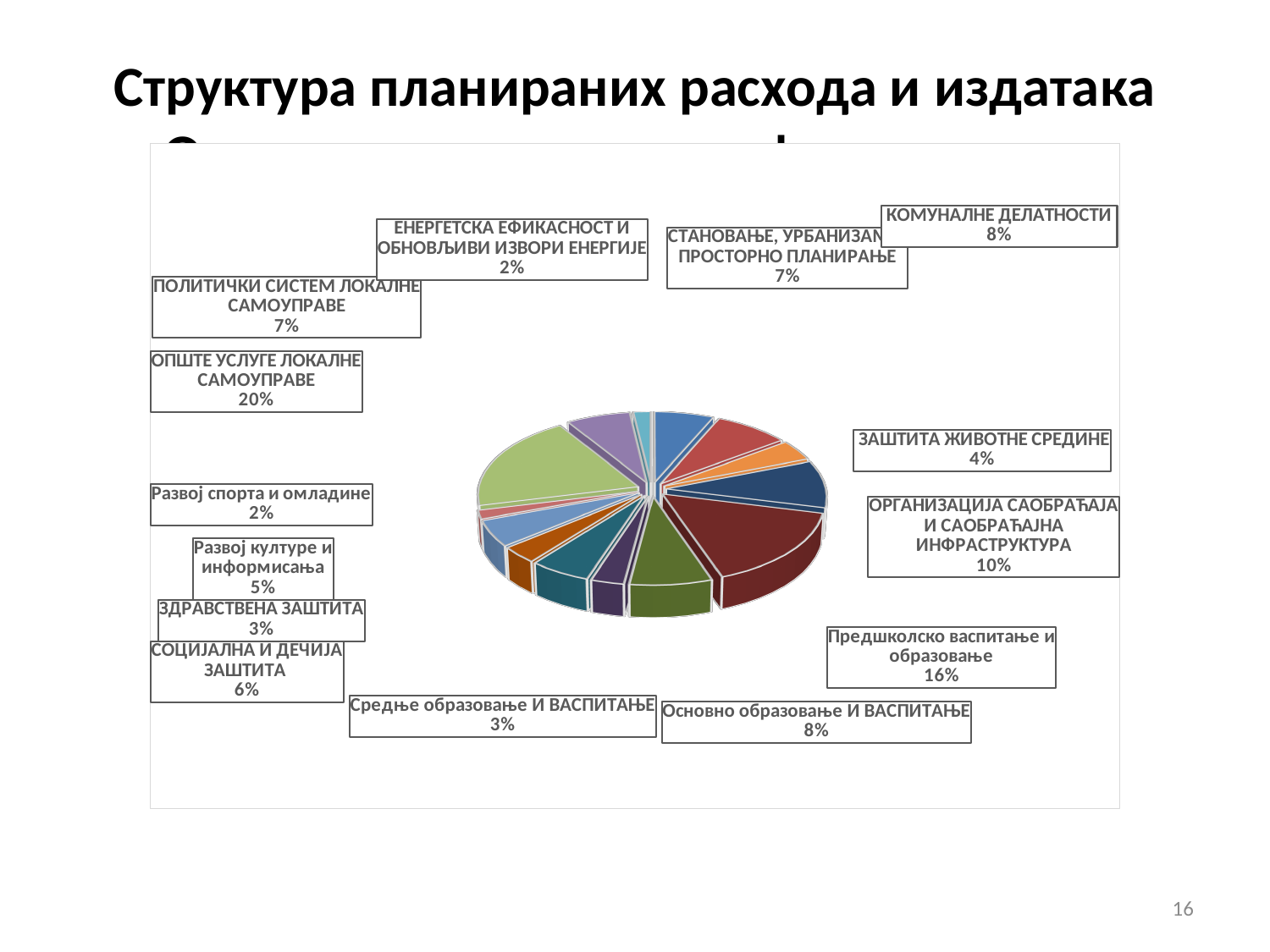
Which category has the largest share of the pie? ОПШТЕ УСЛУГЕ ЛОКАЛНЕ САМОУПРАВЕ What percentage is shown for СОЦИЈАЛНА И ДЕЧИЈА ЗАШТИТА? 6% Which has a larger share: Основно образовање И ВАСПИТАЊЕ or Средње образовање И ВАСПИТАЊЕ? Основно образовање И ВАСПИТАЊЕ What percentage is shown for КОМУНАЛНЕ ДЕЛАТНОСТИ? 8% What share of the pie does ОПШТЕ УСЛУГЕ ЛОКАЛНЕ САМОУПРАВЕ have? 20% What is the first line of the slide title? Структура планираних расхода и издатака What percentage is shown for ОРГАНИЗАЦИЈА САОБРАЋАЈА И САОБРАЋАЈНА ИНФРАСТРУКТУРА? 10% Which has a larger share: Развој културе и информисања or ЗДРАВСТВЕНА ЗАШТИТА? Развој културе и информисања What percentage is shown for ЗАШТИТА ЖИВОТНЕ СРЕДИНЕ? 4% What is the difference in percentage points between ОПШТЕ УСЛУГЕ ЛОКАЛНЕ САМОУПРАВЕ and Предшколско васпитање и образовање? 4 percentage points What percentage is shown for Предшколско васпитање и образовање? 16% What kind of chart is shown on the slide? Pie chart